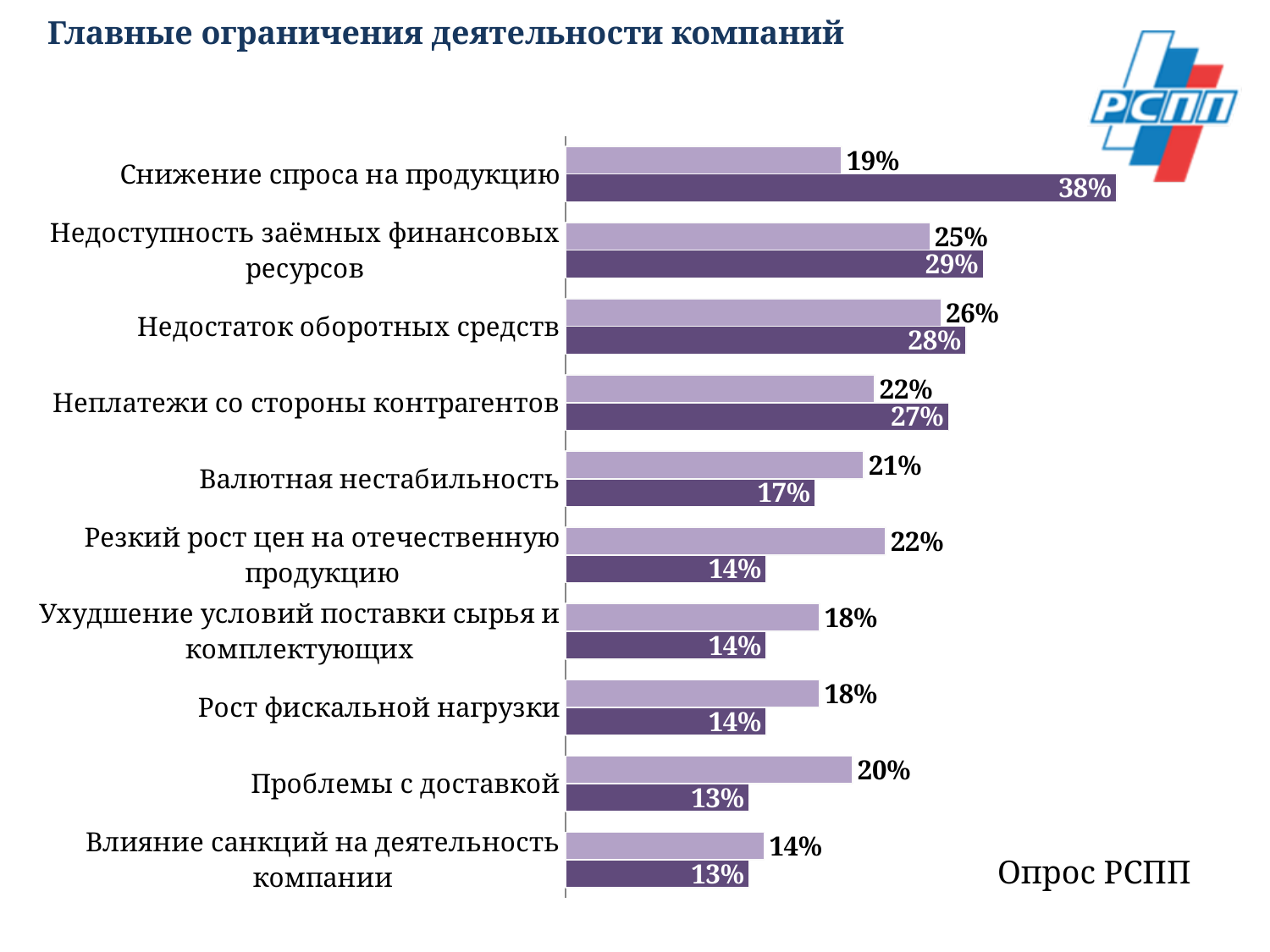
What type of chart is shown on the slide? bar chart Which category has the lowest light purple bar value? Влияние санкций на деятельность компании What is the difference between the light purple and dark purple bar values for "Проблемы с доставкой"? 7% What is the title of the chart on the slide? Главные ограничения деятельности компаний What is the value of the dark purple bar for "Проблемы с доставкой"? 13% Which category has the highest dark purple bar value? Снижение спроса на продукцию What is the difference between the dark purple and light purple bar values for "Снижение спроса на продукцию"? 19% How many categories are shown in the chart? 10 What is the value of the light purple bar for "Недостаток оборотных средств"? 26% Which is larger: the light purple bar for "Резкий рост цен на отечественную продукцию" or the light purple bar for "Рост фискальной нагрузки"? Резкий рост цен на отечественную продукцию For "Валютная нестабильность", which bar is larger: the light purple or the dark purple? light purple What is the value of the dark purple bar for "Снижение спроса на продукцию"? 38%